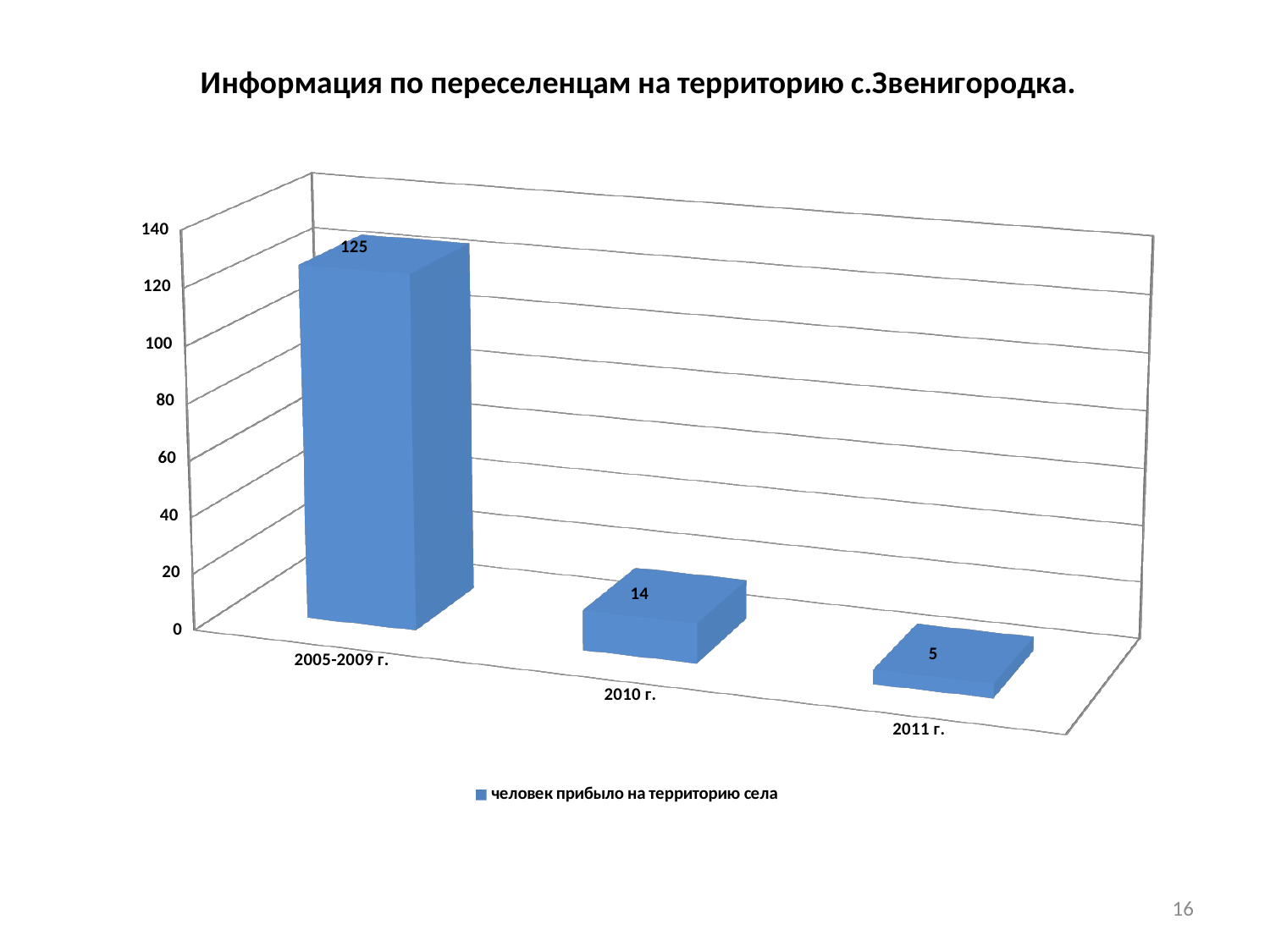
What is the difference between the values for 2010 г. and 2011 г.? 9 What is the difference between the values for 2005-2009 г. and 2010 г.? 111 Which is larger, the value for 2010 г. or the value for 2011 г.? 2010 г. What is the value for 2011 г.? 5 What is the value for 2010 г.? 14 Which category has the lowest value? 2011 г. How many series does the legend list? 1 What is the value for 2005-2009 г.? 125 How many categories are shown on the x axis? 3 Do the values rise or fall from left to right along the x axis? fall Which category has the highest value? 2005-2009 г. What kind of chart is shown on the slide? bar chart